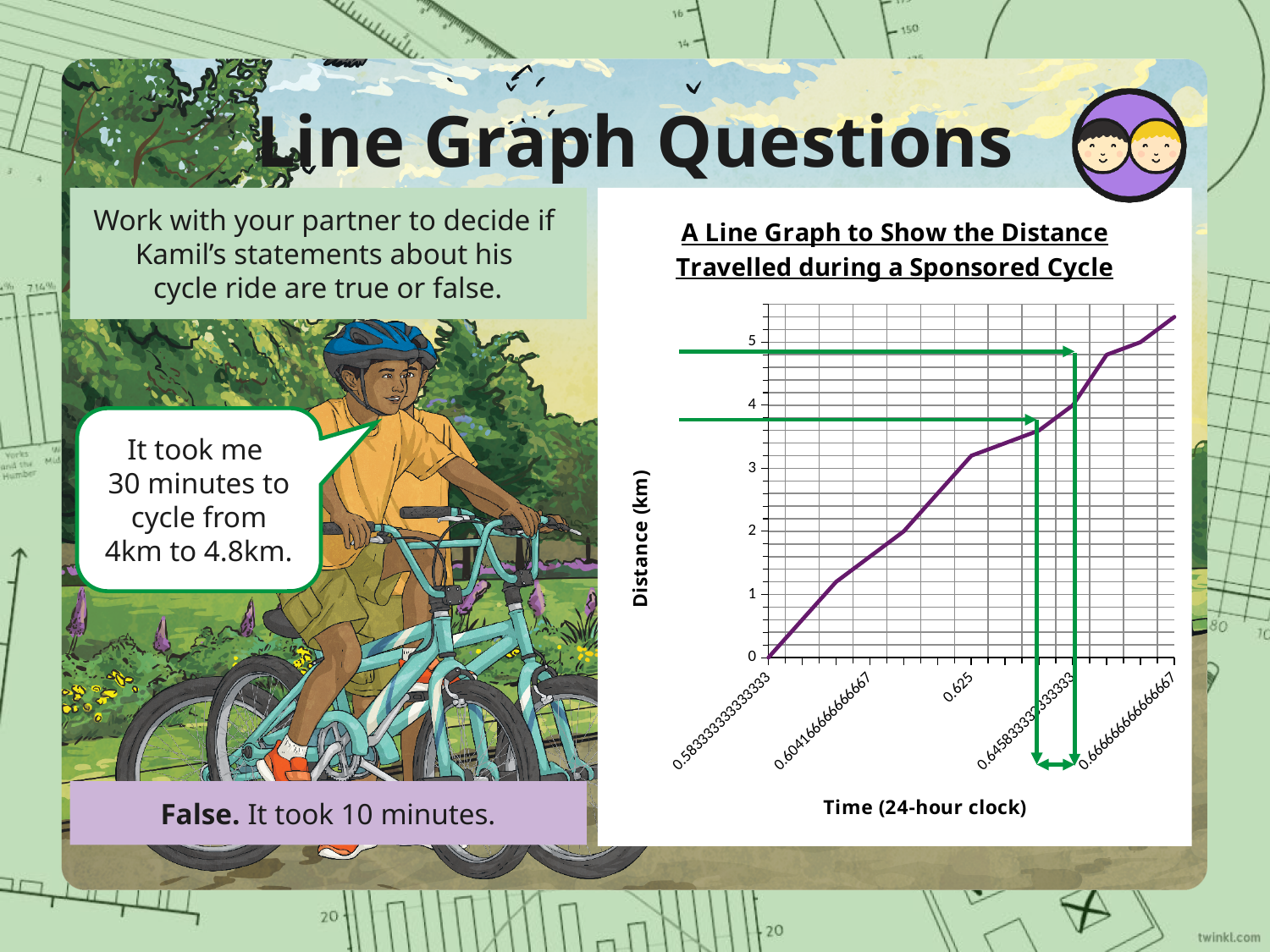
What is the label on the vertical axis of the chart? Distance (km) What is the distance travelled at the first time point, 0.583333333333333? 0 Does the distance rise or fall as time increases along the x axis? rise Is the distance at time 0.625 greater or less than 3? greater At which labelled time is the distance travelled highest? 0.666666666666667 Is the distance at time 0.604166666666667 greater or less than 1? greater What is the title of the chart? A Line Graph to Show the Distance Travelled during a Sponsored Cycle Which is larger: the distance at time 0.625 or the distance at time 0.604166666666667? 0.625 What kind of chart is shown on the slide? line chart Is the distance at time 0.666666666666667 greater or less than 5? greater At which labelled time is the distance travelled lowest? 0.583333333333333